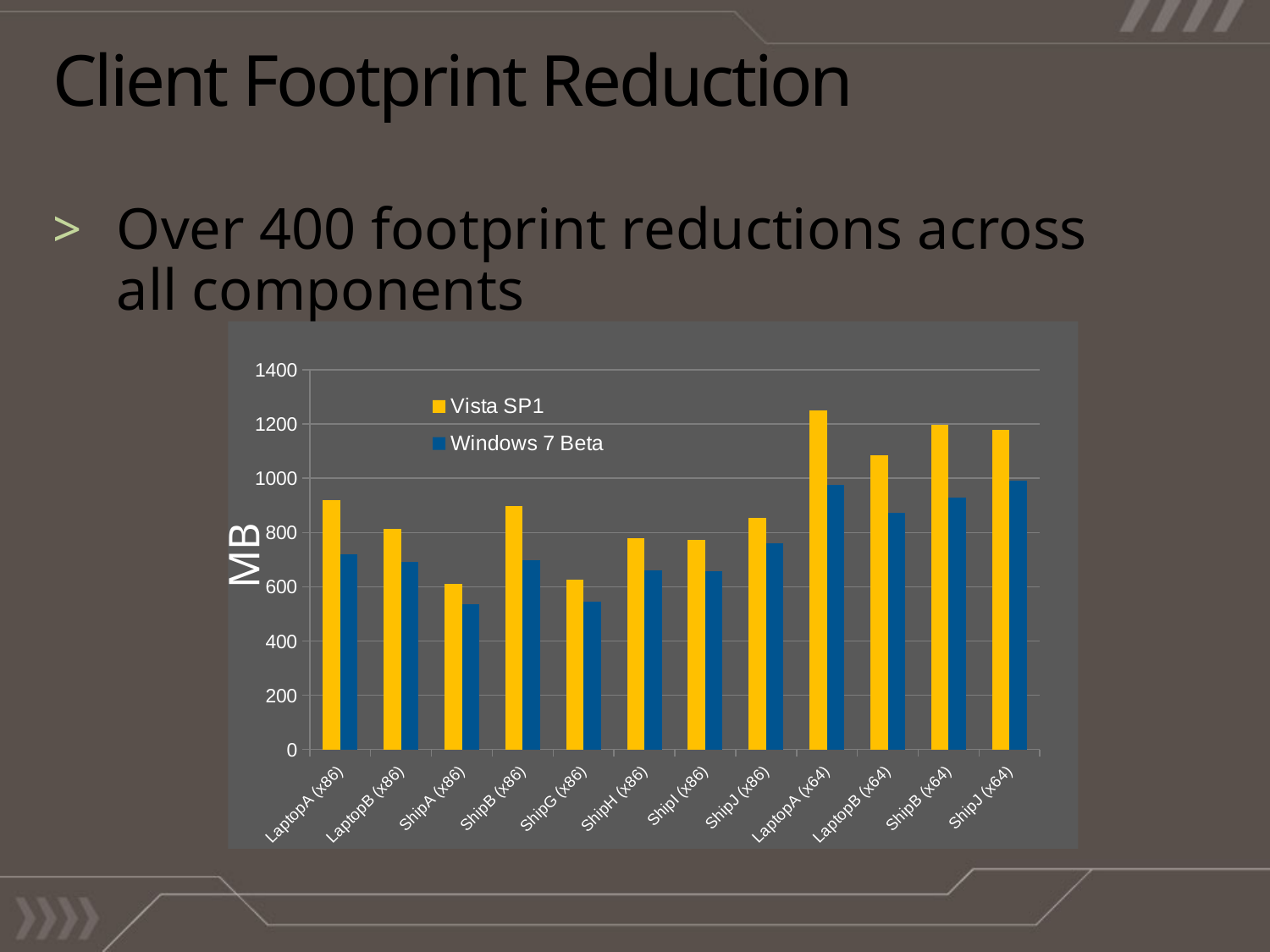
What kind of chart is shown on the slide? bar chart Is the Windows 7 Beta value for ShipA (x86) greater or less than 600? less What is the label on the chart's vertical axis? MB How many categories are shown along the x axis of the chart? 12 Is the Vista SP1 value for LaptopB (x64) greater or less than 1000? greater How many series does the chart's legend list? 2 Which category has the highest Vista SP1 value? LaptopA (x64) Which has the larger Vista SP1 value, LaptopB (x86) or ShipB (x86)? ShipB (x86) Is the Vista SP1 value for LaptopA (x86) greater or less than 800? greater For LaptopA (x86), which series has the larger value, Vista SP1 or Windows 7 Beta? Vista SP1